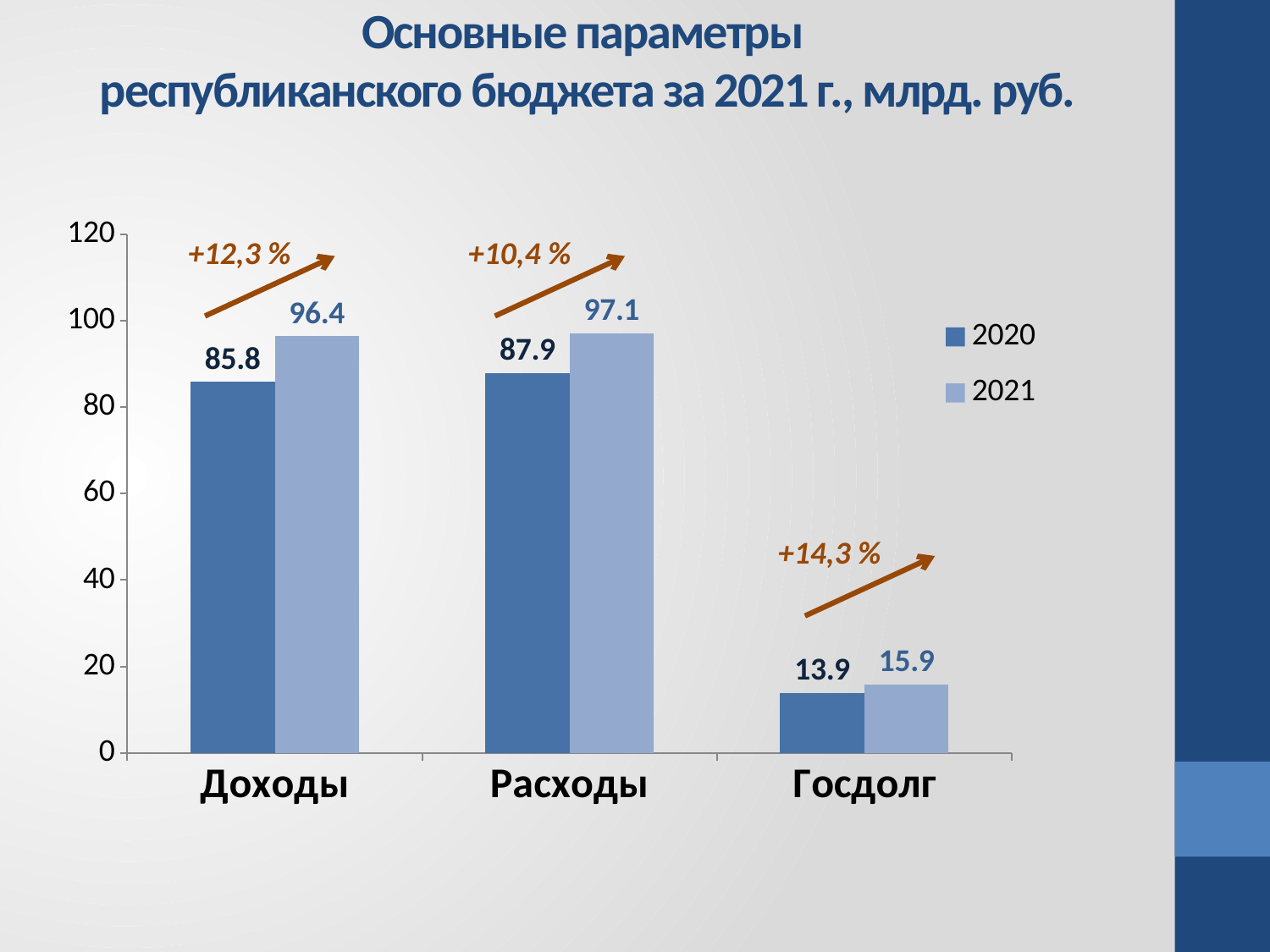
How many series does the legend list? 2 Which is larger: Расходы in 2020 or Доходы in 2021? Доходы in 2021 Which category has the highest value in 2021? Расходы What is the difference between the 2021 and 2020 values for Госдолг? 2.0 What is the value for Доходы in 2020? 85.8 Which category has the lowest value in 2020? Госдолг What kind of chart is shown on the slide? bar chart What is the value for Госдолг in 2021? 15.9 What percentage change is annotated above the Госдолг bars? +14,3 % What is the difference between the 2021 and 2020 values for Доходы? 10.6 How many categories are shown on the x axis? 3 What is the value for Расходы in 2021? 97.1